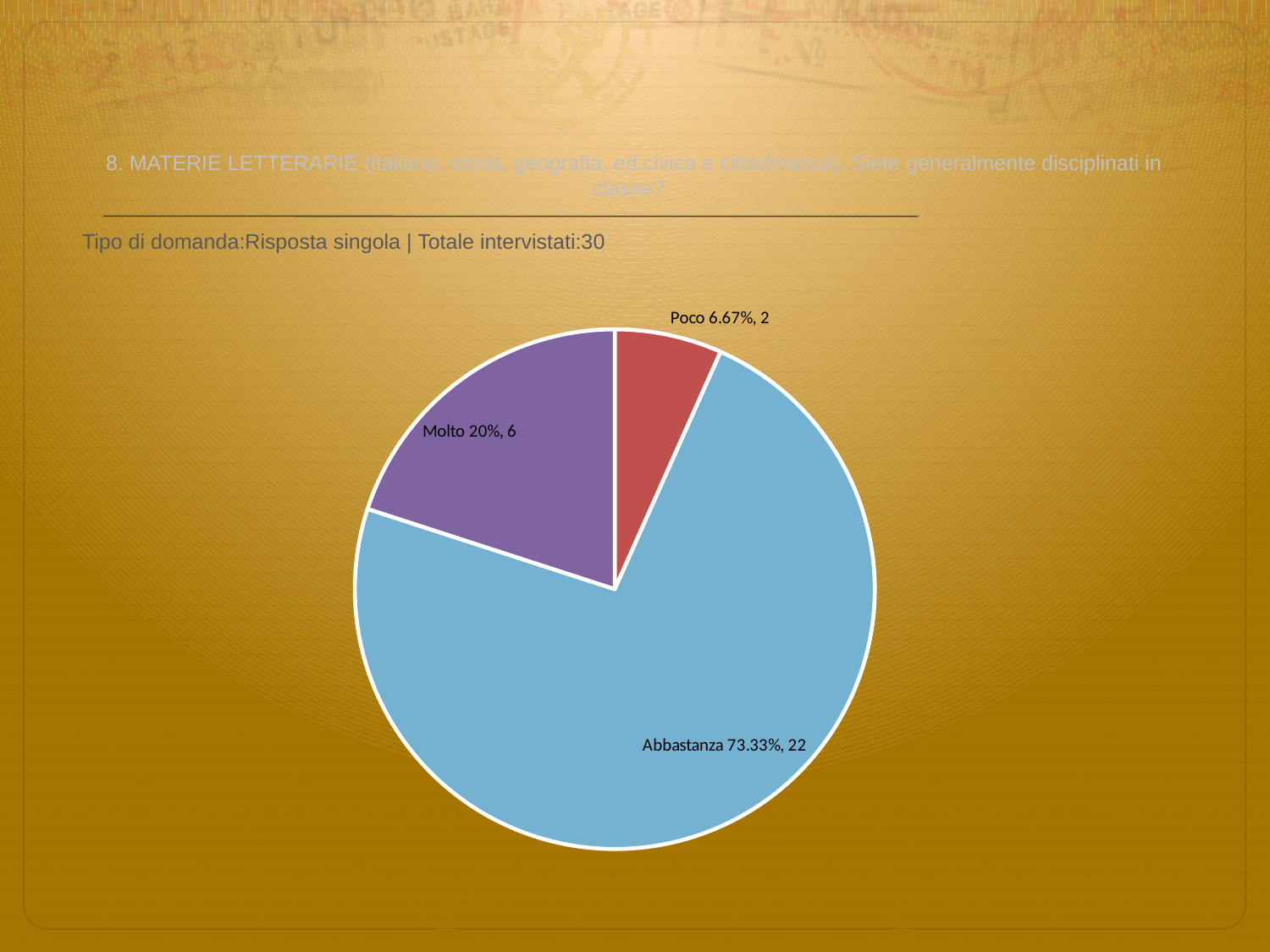
What percentage share does the Poco slice have? 6.67% Which category has the largest slice of the pie? Abbastanza What kind of chart is shown on the slide? pie chart Which category has the smallest slice of the pie? Poco How many slices does the pie chart have? 3 What is the difference in respondent count between Abbastanza and Molto? 16 Which has more respondents, Molto or Poco? Molto How many respondents answered Molto? 6 How many respondents answered Poco? 2 What percentage share does the Abbastanza slice have? 73.33% What percentage share does the Molto slice have? 20% How many respondents answered Abbastanza? 22